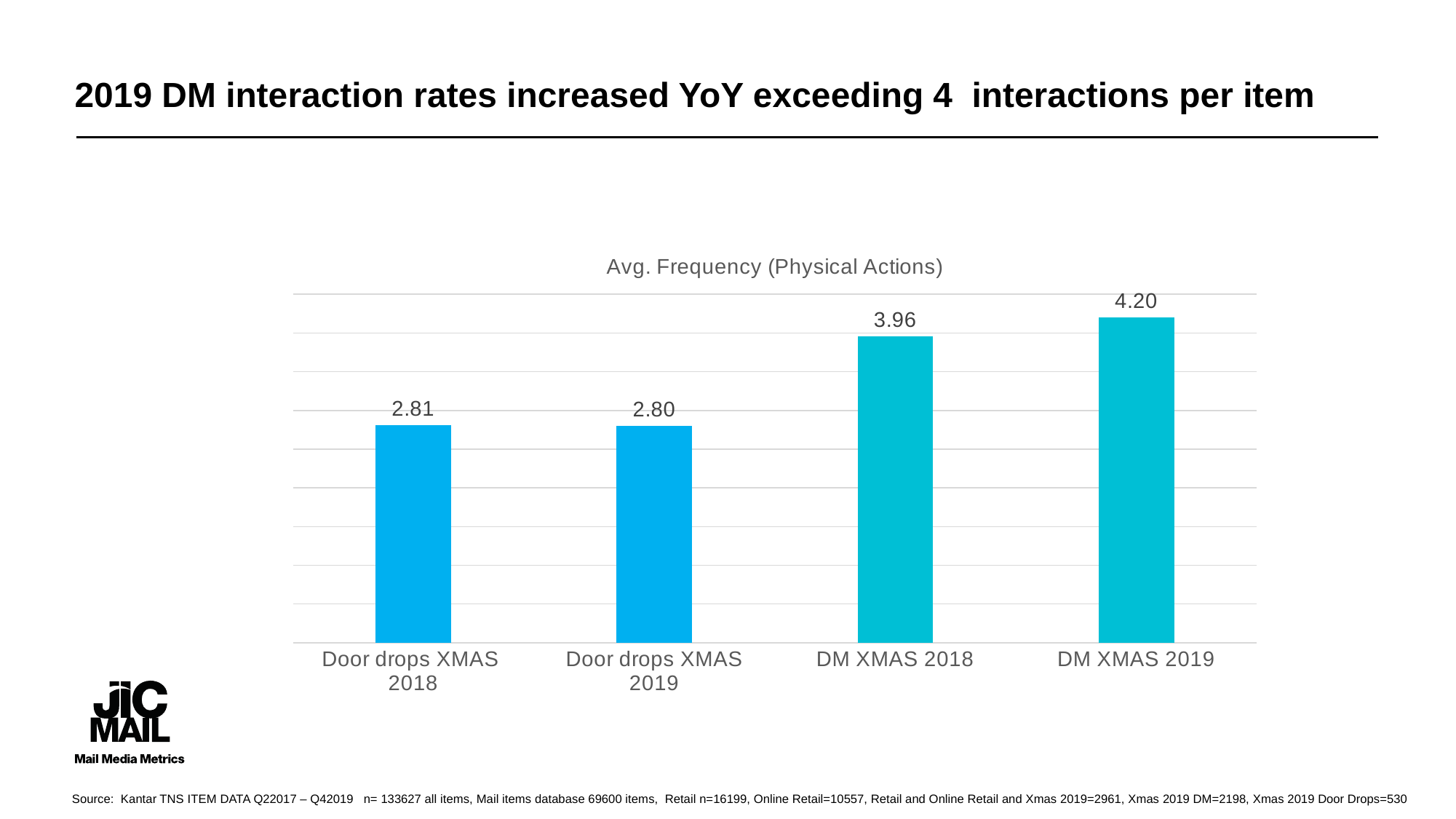
How many categories are shown on the chart? 4 What kind of chart is shown on the slide? Bar chart Which category has the highest value? DM XMAS 2019 Which is larger, the value for DM XMAS 2018 or the value for Door drops XMAS 2019? DM XMAS 2018 Do the values rise or fall from DM XMAS 2018 to DM XMAS 2019? Rise What is the value for DM XMAS 2019? 4.20 What is the difference between the values for DM XMAS 2019 and DM XMAS 2018? 0.24 What is the title of the chart? Avg. Frequency (Physical Actions) What is the value for DM XMAS 2018? 3.96 What is the difference between the values for DM XMAS 2018 and Door drops XMAS 2018? 1.15 What is the value for Door drops XMAS 2019? 2.80 What is the value for Door drops XMAS 2018? 2.81